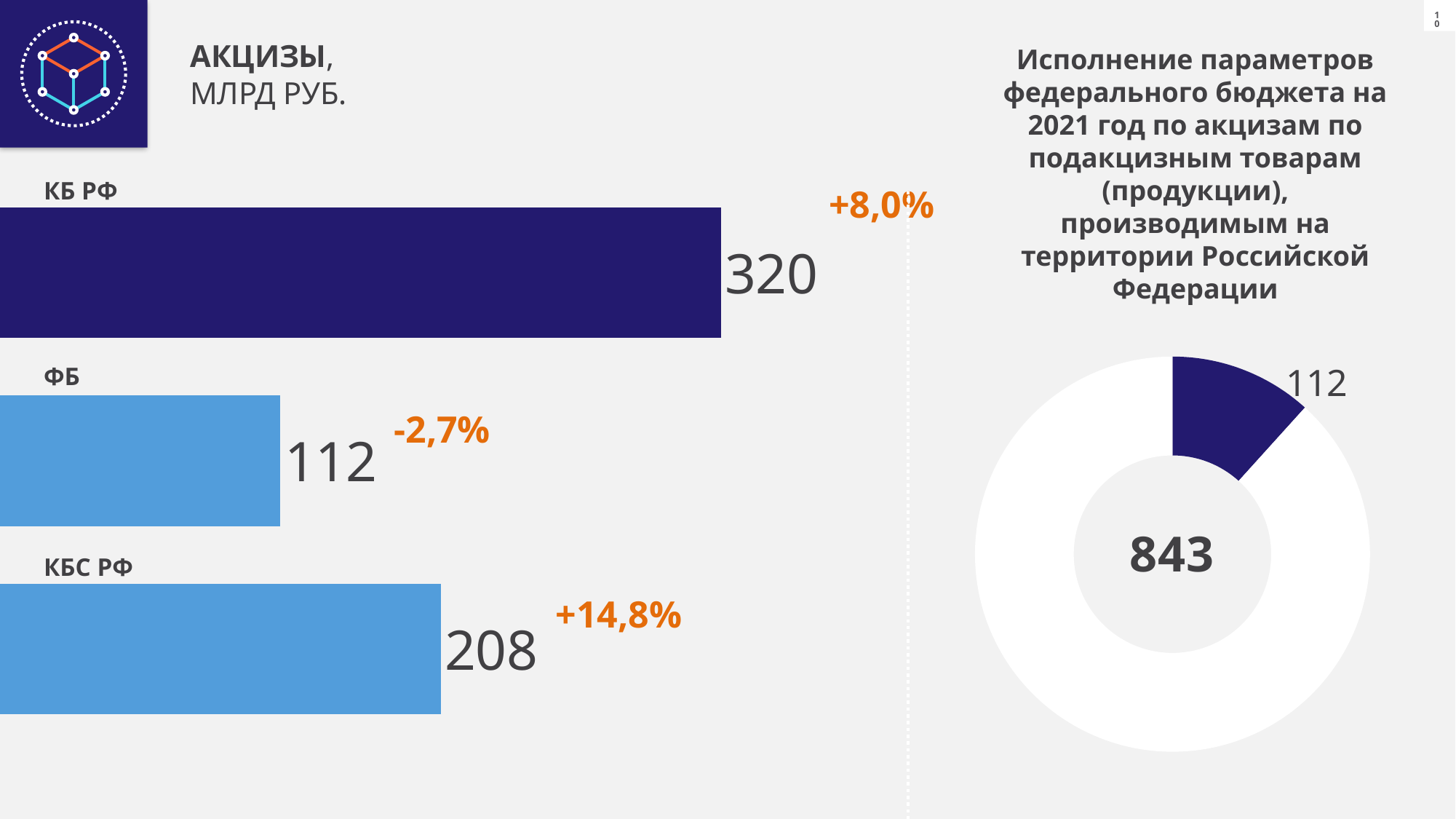
In the bar chart titled АКЦИЗЫ, МЛРД РУБ., which category has the lowest value? ФБ In the bar chart titled АКЦИЗЫ, МЛРД РУБ., what is the value for ФБ? 112 In the bar chart titled АКЦИЗЫ, МЛРД РУБ., which is larger, the value for ФБ or the value for КБС РФ? КБС РФ In the bar chart titled АКЦИЗЫ, МЛРД РУБ., what percentage change is shown next to the ФБ bar? -2,7% In the bar chart titled АКЦИЗЫ, МЛРД РУБ., what is the difference between the values for КБ РФ and КБС РФ? 112 In the bar chart titled АКЦИЗЫ, МЛРД РУБ., what is the value for КБ РФ? 320 In the bar chart titled АКЦИЗЫ, МЛРД РУБ., which category has the highest value? КБ РФ What kind of chart is the chart on the left of the slide titled АКЦИЗЫ, МЛРД РУБ.? bar chart In the bar chart titled АКЦИЗЫ, МЛРД РУБ., how many categories are shown? 3 In the bar chart titled АКЦИЗЫ, МЛРД РУБ., what percentage change is shown next to the КБС РФ bar? +14,8% In the donut chart on the right of the slide, what number is shown in the centre? 843 In the bar chart titled АКЦИЗЫ, МЛРД РУБ., what is the value for КБС РФ? 208